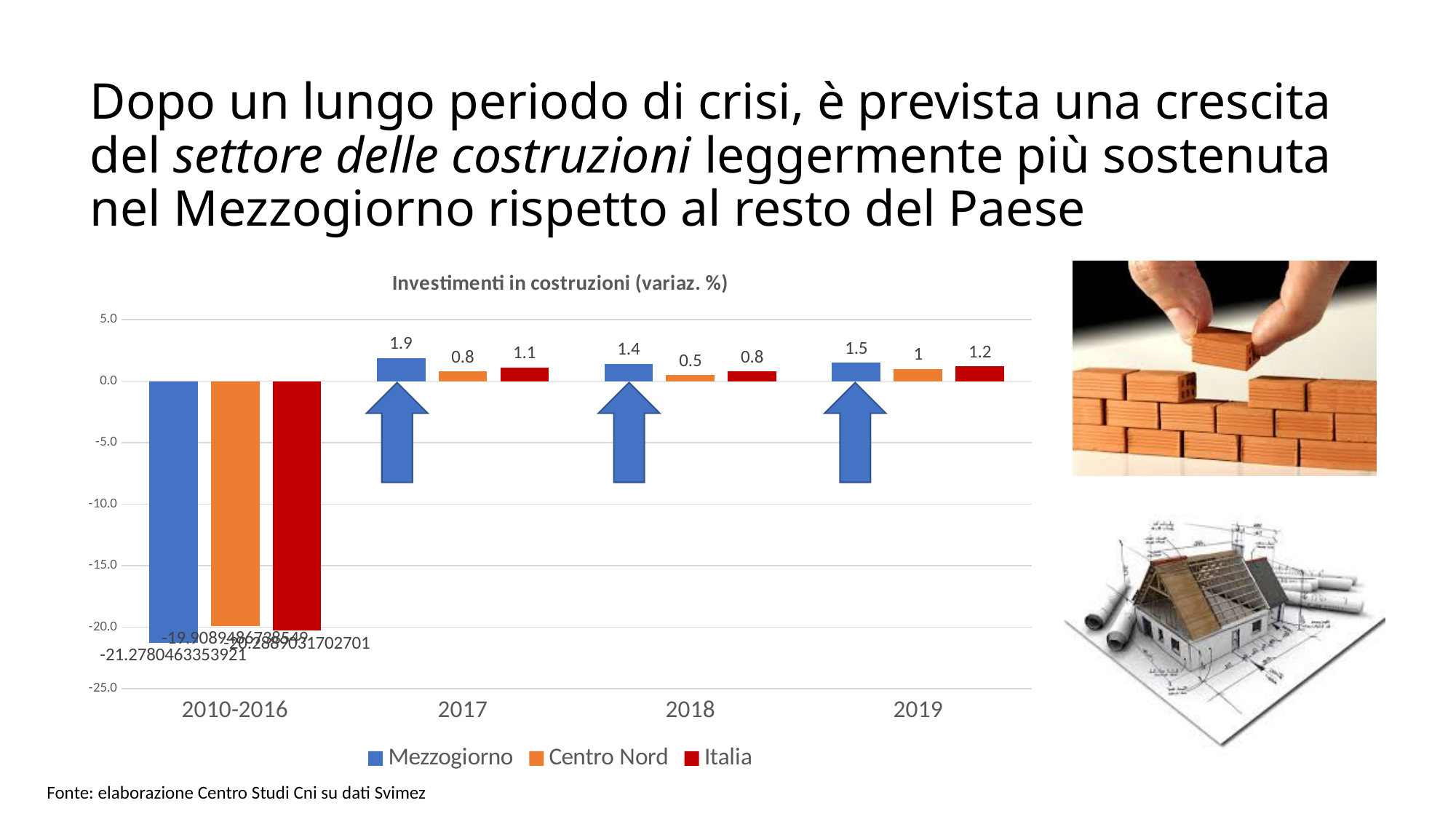
What is the value for Centro Nord in 2018? 0.5 Which series has the highest value in 2017? Mezzogiorno Which series has the lowest value in 2018? Centro Nord What is the value for Centro Nord in 2019? 1 Is the value for Mezzogiorno in 2010-2016 greater or less than -20.0? less How many categories are shown on the x axis? 4 What is the value for Mezzogiorno in 2017? 1.9 What is the value for Italia in 2019? 1.2 What is the difference between the Mezzogiorno and Centro Nord values in 2017? 1.1 Is the value for Italia larger in 2017 or in 2018? 2017 What kind of chart is shown on the slide? bar chart How many series does the legend list? 3